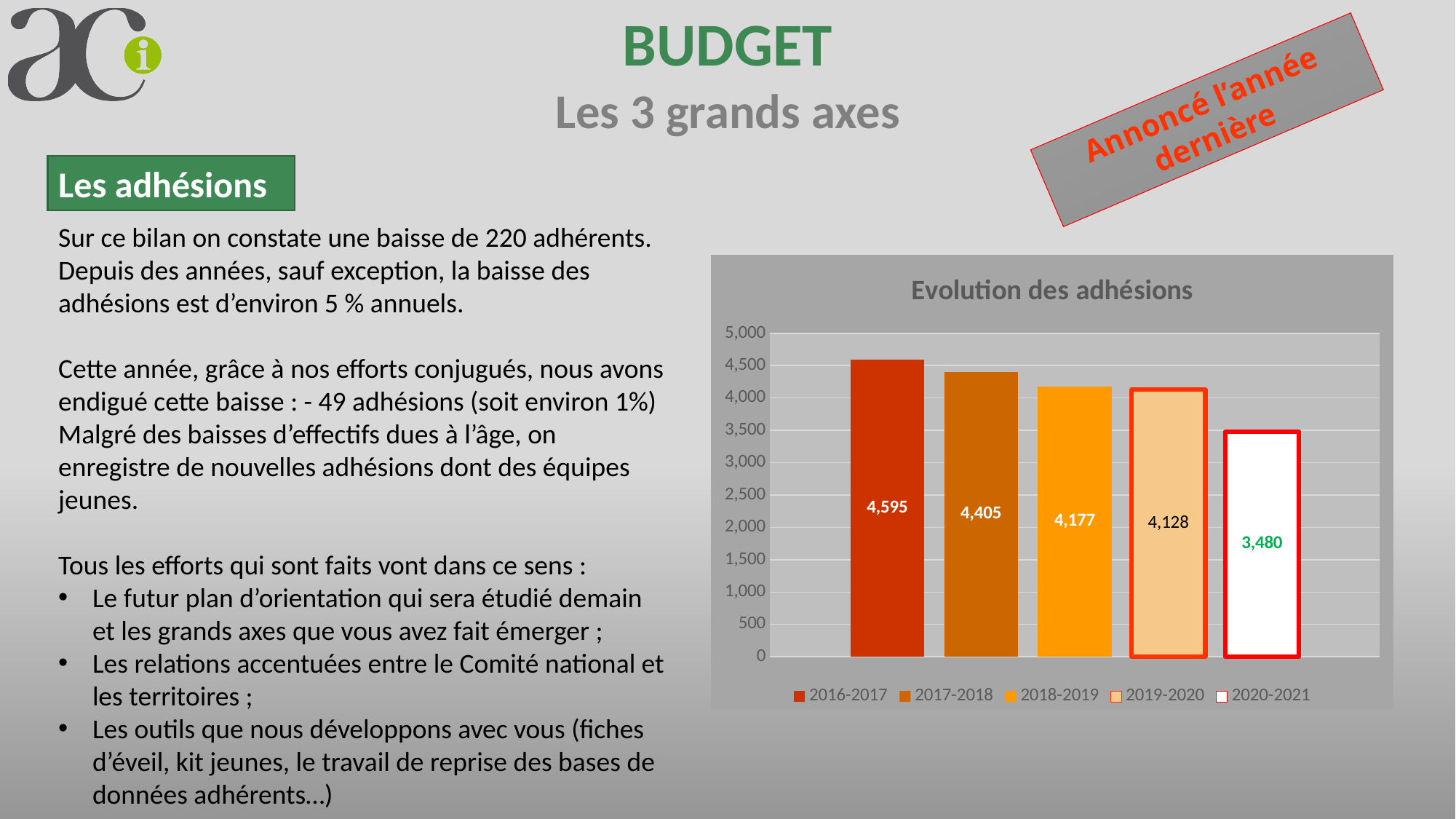
What is the value for 2016-2017 in the 'Evolution des adhésions' chart? 4,595 What is the difference between the values for 2019-2020 and 2020-2021 in the 'Evolution des adhésions' chart? 648 How many bars are plotted in the 'Evolution des adhésions' chart? 5 What is the difference between the values for 2016-2017 and 2017-2018 in the 'Evolution des adhésions' chart? 190 What is the value for 2020-2021 in the 'Evolution des adhésions' chart? 3,480 Which year has the lowest value in the 'Evolution des adhésions' chart? 2020-2021 What is the value for 2018-2019 in the 'Evolution des adhésions' chart? 4,177 Which year has the highest value in the 'Evolution des adhésions' chart? 2016-2017 What kind of chart is 'Evolution des adhésions'? bar chart Is the value for 2020-2021 in the 'Evolution des adhésions' chart greater or less than 4,000? less Do the values in the 'Evolution des adhésions' chart rise or fall from 2016-2017 to 2020-2021? fall Which is larger in the 'Evolution des adhésions' chart, the value for 2017-2018 or the value for 2018-2019? 2017-2018